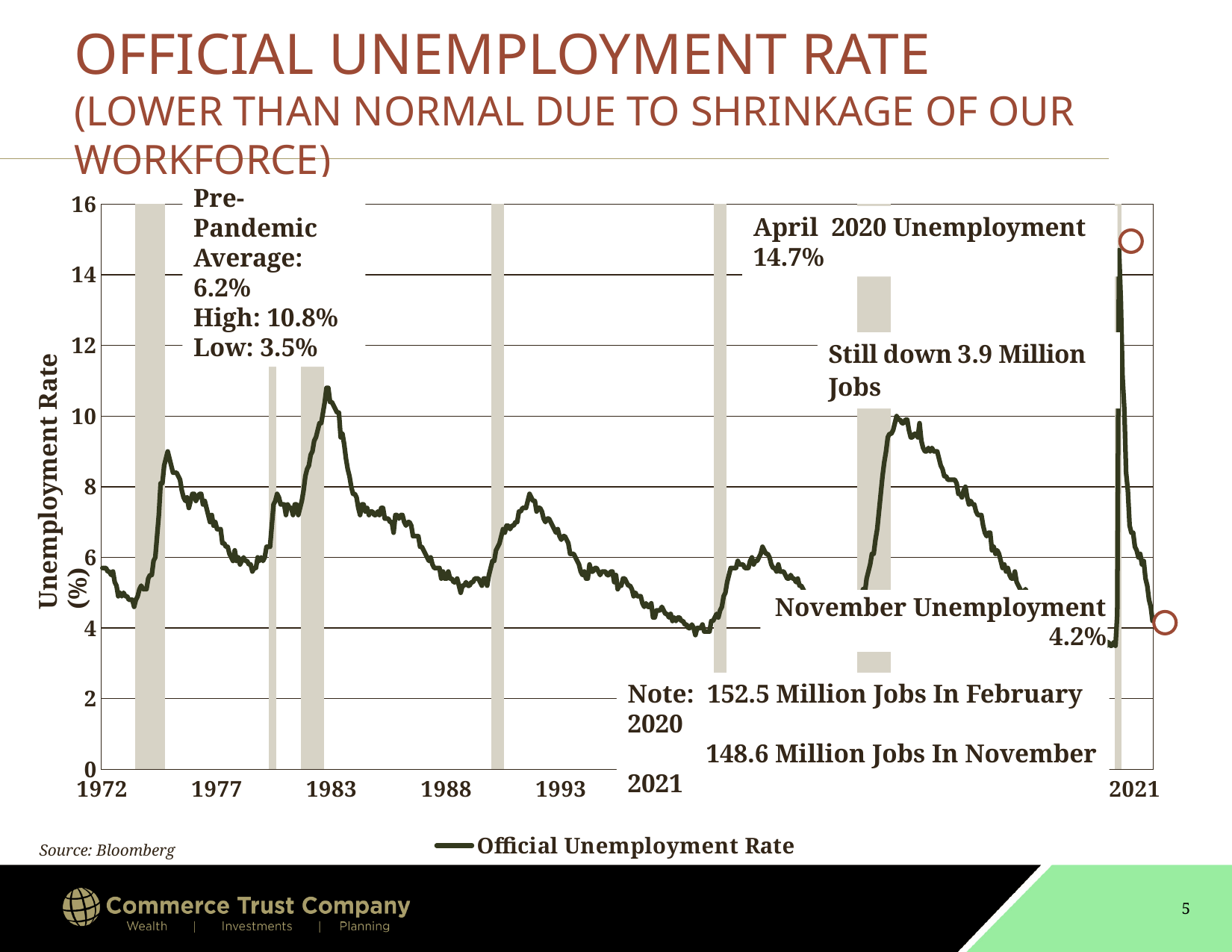
What was the November unemployment rate according to the chart annotation? 4.2% What is the pre-pandemic low unemployment rate shown on the chart? 3.5% Which is higher: the April 2020 unemployment rate or the pre-pandemic high? April 2020 unemployment rate Is the unemployment rate at the start of the chart in 1972 greater or less than 8? less By how many percentage points did the unemployment rate fall from April 2020 (14.7%) to November (4.2%)? 10.5 percentage points What kind of chart is shown on the slide? line chart What is the pre-pandemic high unemployment rate shown on the chart? 10.8% What was the unemployment rate in April 2020 according to the chart annotation? 14.7% What is the name of the series shown in the chart legend? Official Unemployment Rate How many series does the chart legend list? 1 At what point does the unemployment rate line reach its highest value on the chart? April 2020 What is the pre-pandemic average unemployment rate shown on the chart? 6.2%